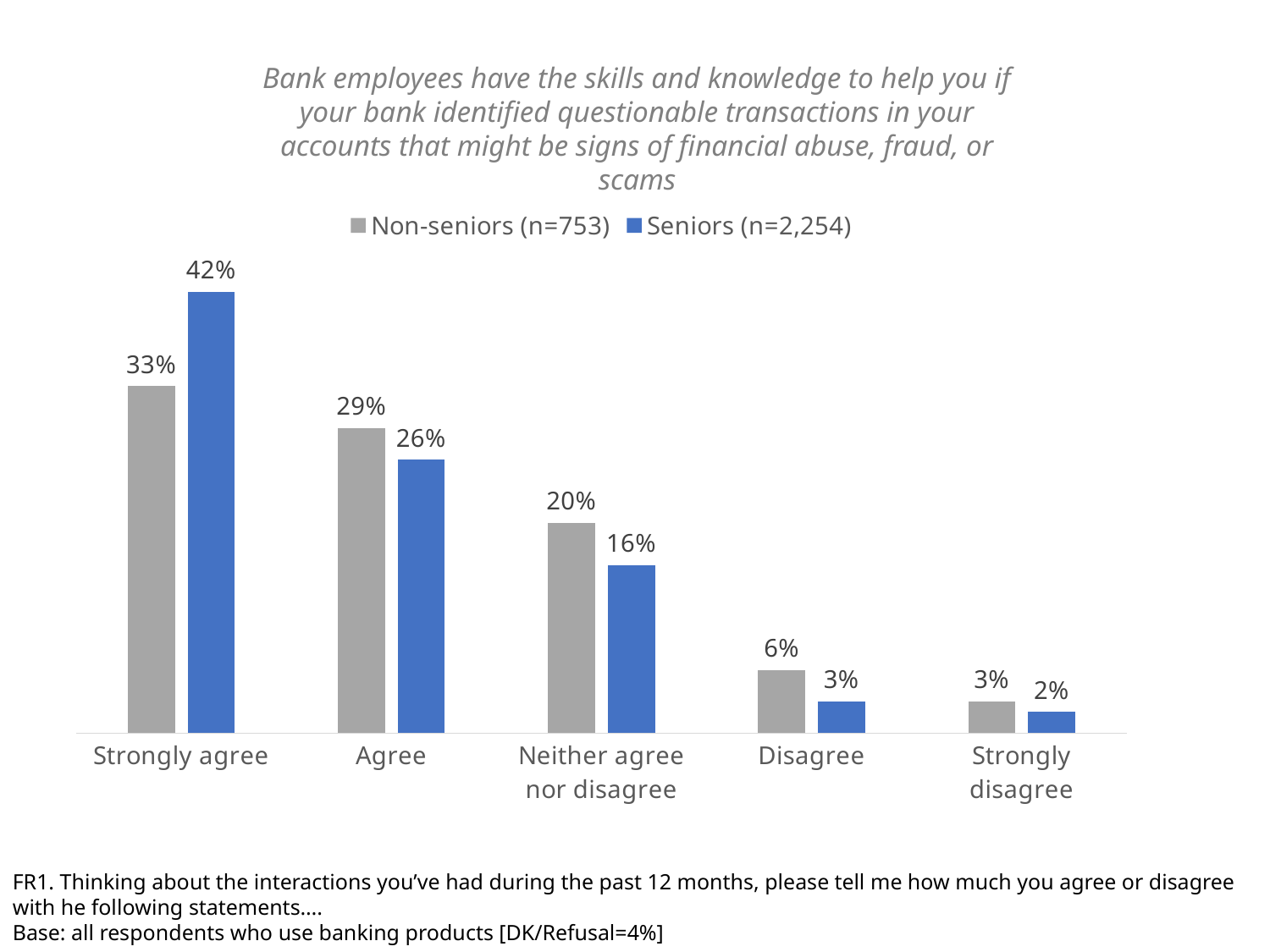
Do the values for Seniors rise or fall moving from 'Strongly agree' to 'Strongly disagree'? Fall What is the difference between Seniors and Non-seniors for 'Strongly agree'? 9 percentage points What is the sample size (n) for the Seniors series shown in the legend? 2,254 What percentage of Seniors strongly agree that bank employees have the skills and knowledge to help with questionable transactions? 42% What kind of chart is shown on the slide? Bar chart Which response category has the highest value for Seniors? Strongly agree What is the value for Seniors in the 'Neither agree nor disagree' category? 16% How many series does the legend list? 2 What percentage of Non-seniors chose 'Agree'? 29% Which response category has the lowest value for Non-seniors? Strongly disagree Which group has the larger value for 'Disagree', Non-seniors or Seniors? Non-seniors How many response categories are shown on the x axis? 5